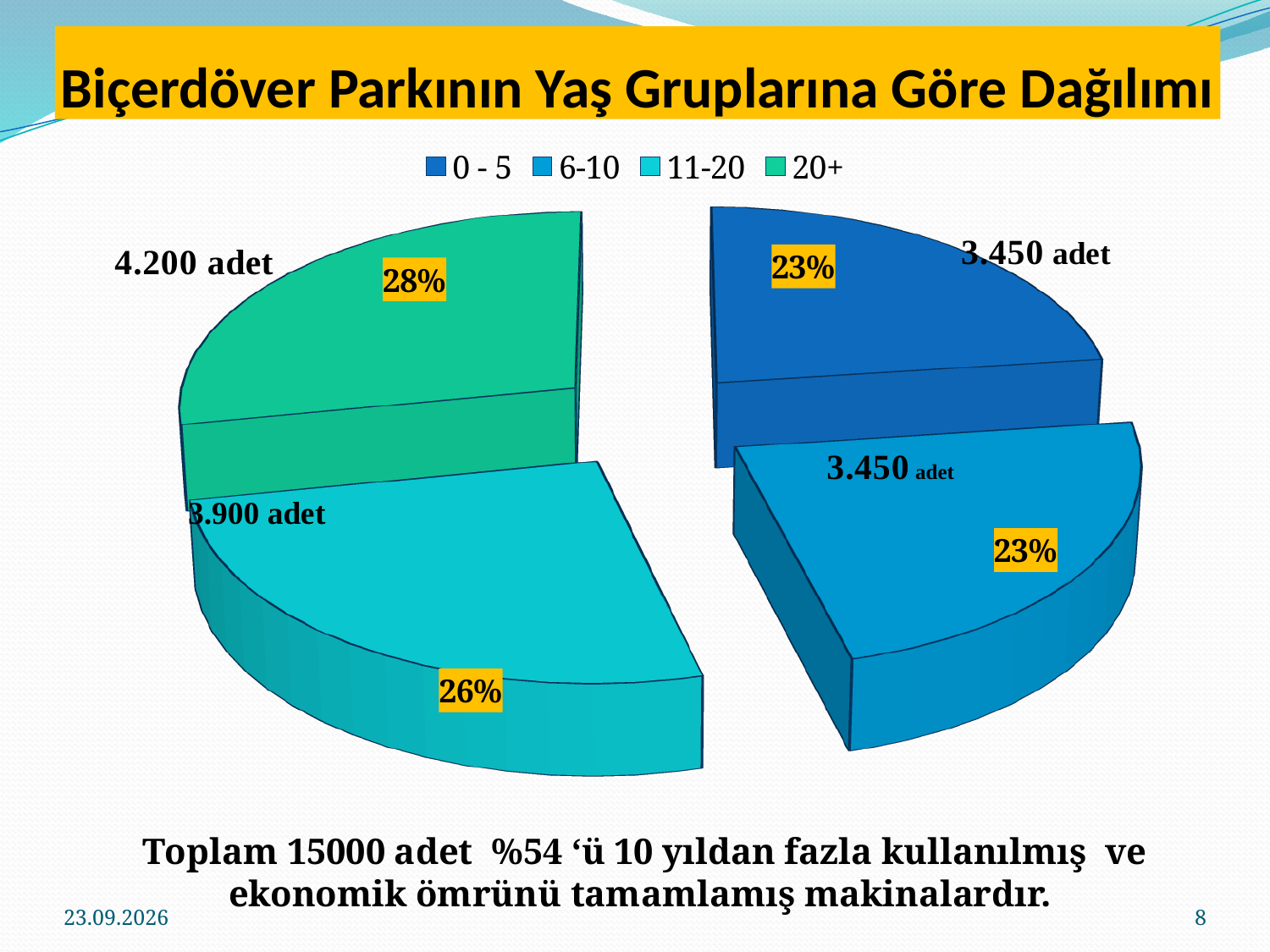
What is the title of the chart? Biçerdöver Parkının Yaş Gruplarına Göre Dağılımı What percentage share does the 20+ age group have? 28% Which has a larger share, the 11-20 group or the 6-10 group? 11-20 How many age groups does the legend list? 4 What percentage share does the 11-20 age group have? 26% What is the difference in percentage points between the 20+ group and the 11-20 group? 2 How many slices does the pie chart have? 4 How many units (adet) are in the 11-20 age group? 3.900 adet How many units (adet) are in the 20+ age group? 4.200 adet What type of chart is shown on the slide? pie chart Which age group has the largest share of the pie? 20+ What percentage share does the 0 - 5 age group have? 23%